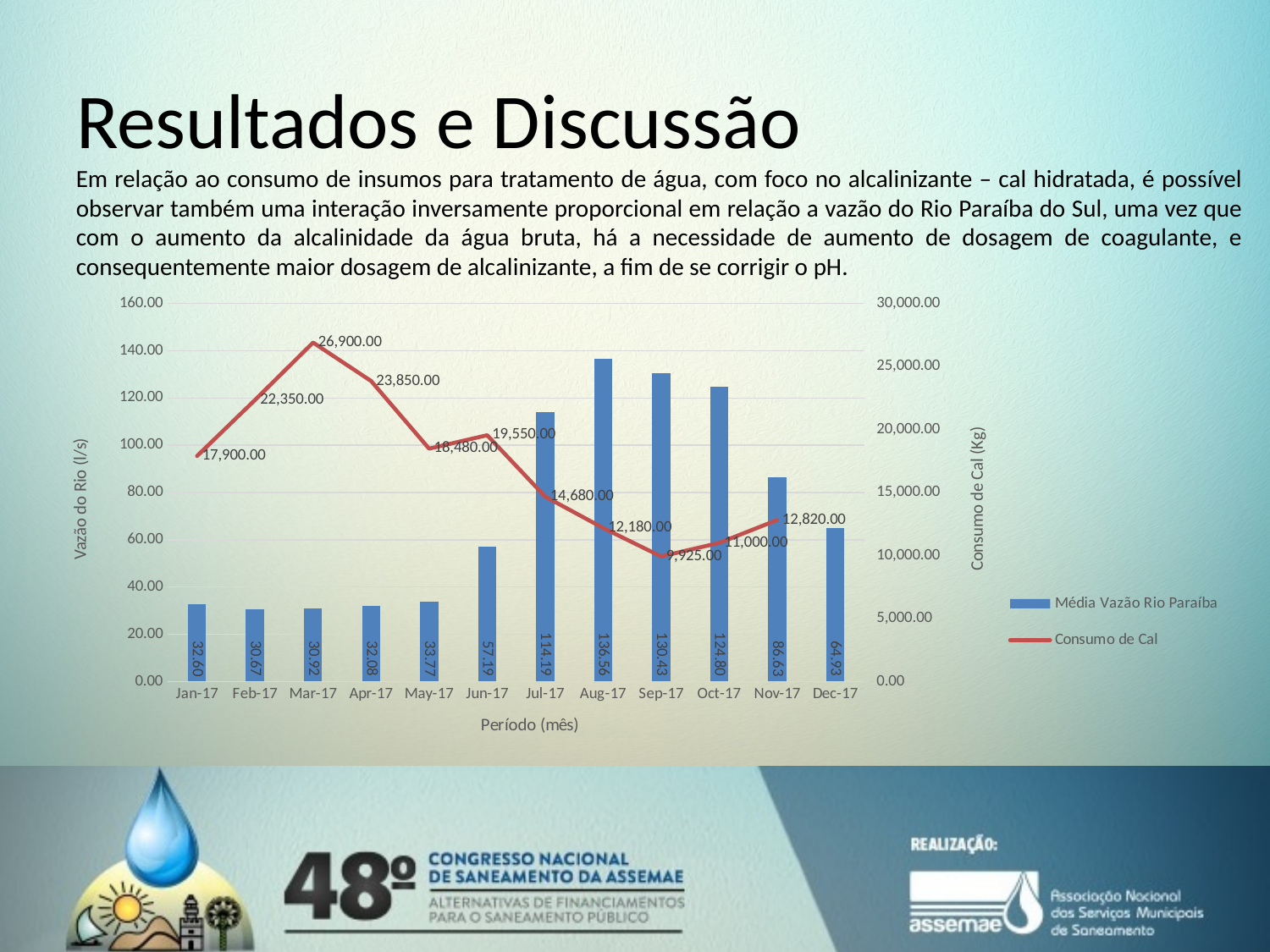
Which month has the lowest Consumo de Cal? Sep-17 What is the Consumo de Cal value for Mar-17? 26,900.00 What is the difference between the Consumo de Cal values for Mar-17 and Apr-17? 3,050.00 What is the Média Vazão Rio Paraíba value for Jan-17? 32.60 Does the Consumo de Cal line rise or fall from Mar-17 to Sep-17? fall How many months are shown on the x axis? 12 What is the Consumo de Cal value for Sep-17? 9,925.00 How many series does the legend list? 2 Which month has the highest Média Vazão Rio Paraíba? Aug-17 What is the Média Vazão Rio Paraíba value for Aug-17? 136.56 Which is larger, the Média Vazão Rio Paraíba for Sep-17 or for Oct-17? Sep-17 What is the label of the left vertical axis? Vazão do Rio (l/s)